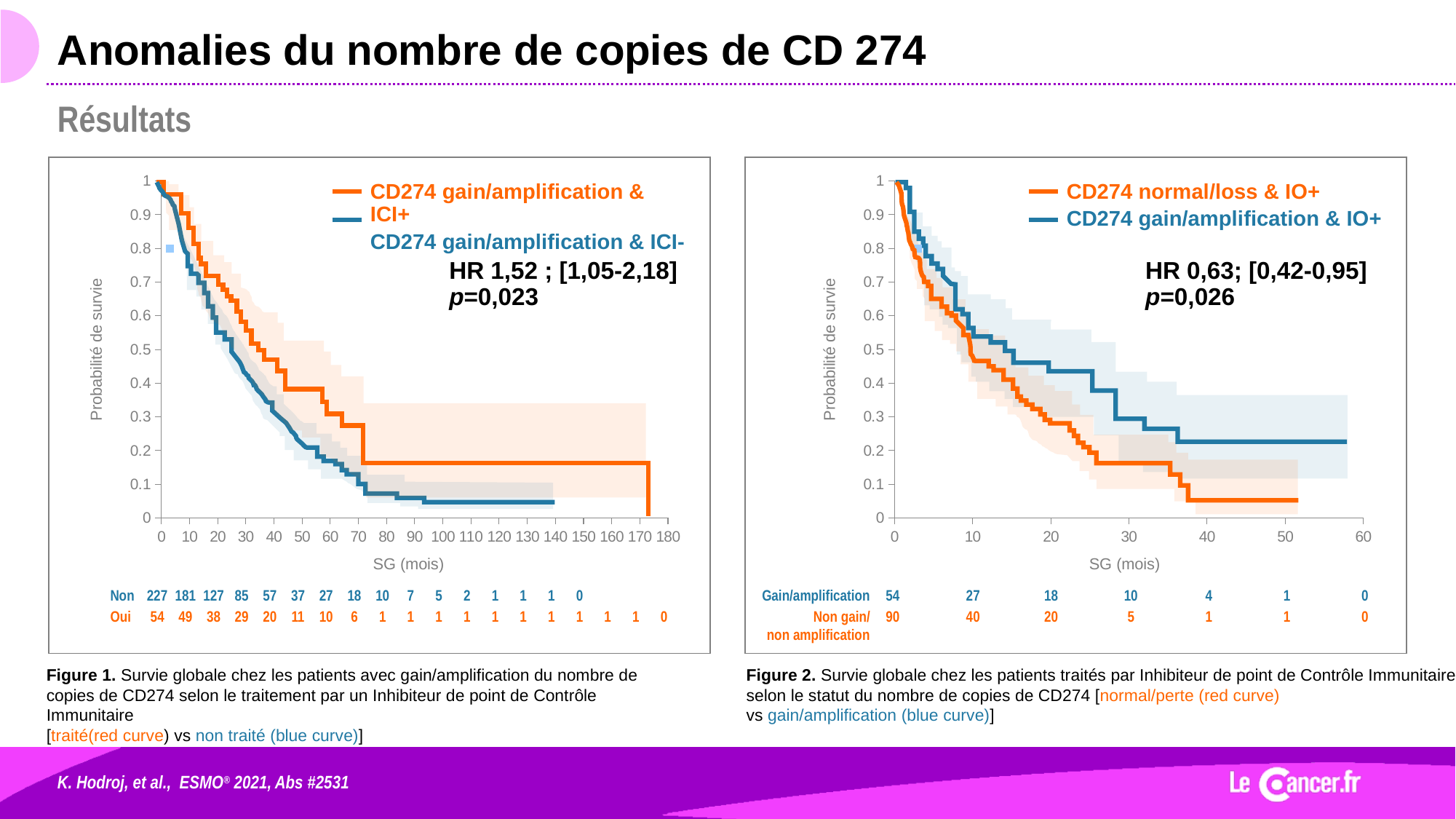
In Figure 1, how many series does the legend list? 2 In Figure 2, how many patients are at risk in the 'Gain/amplification' group at 20 months? 18 In Figure 2, what is the difference between the number at risk at time 0 in the 'Non gain/non amplification' group and the 'Gain/amplification' group? 36 In Figure 2, do the survival curves rise or fall along the x axis? Fall In Figure 1, how many patients are at risk in the 'Non' group at time 0? 227 In Figure 1, how many patients are at risk in the 'Oui' group at time 0? 54 In Figure 2, how many patients are at risk in the 'Non gain/non amplification' group at 10 months? 40 What kind of chart is shown in Figure 1? Line chart (Kaplan-Meier survival curve) What hazard ratio is reported in Figure 2? HR 0,63; [0,42-0,95] In Figure 2, how many series does the legend list? 2 In Figure 1, is the survival probability of the orange curve (CD274 gain/amplification & ICI+) at 100 months greater or less than 0.1? greater In Figure 2, at 20 months, which curve shows the higher survival probability, the blue (gain/amplification & IO+) or the orange (normal/loss & IO+)? Blue (CD274 gain/amplification & IO+)